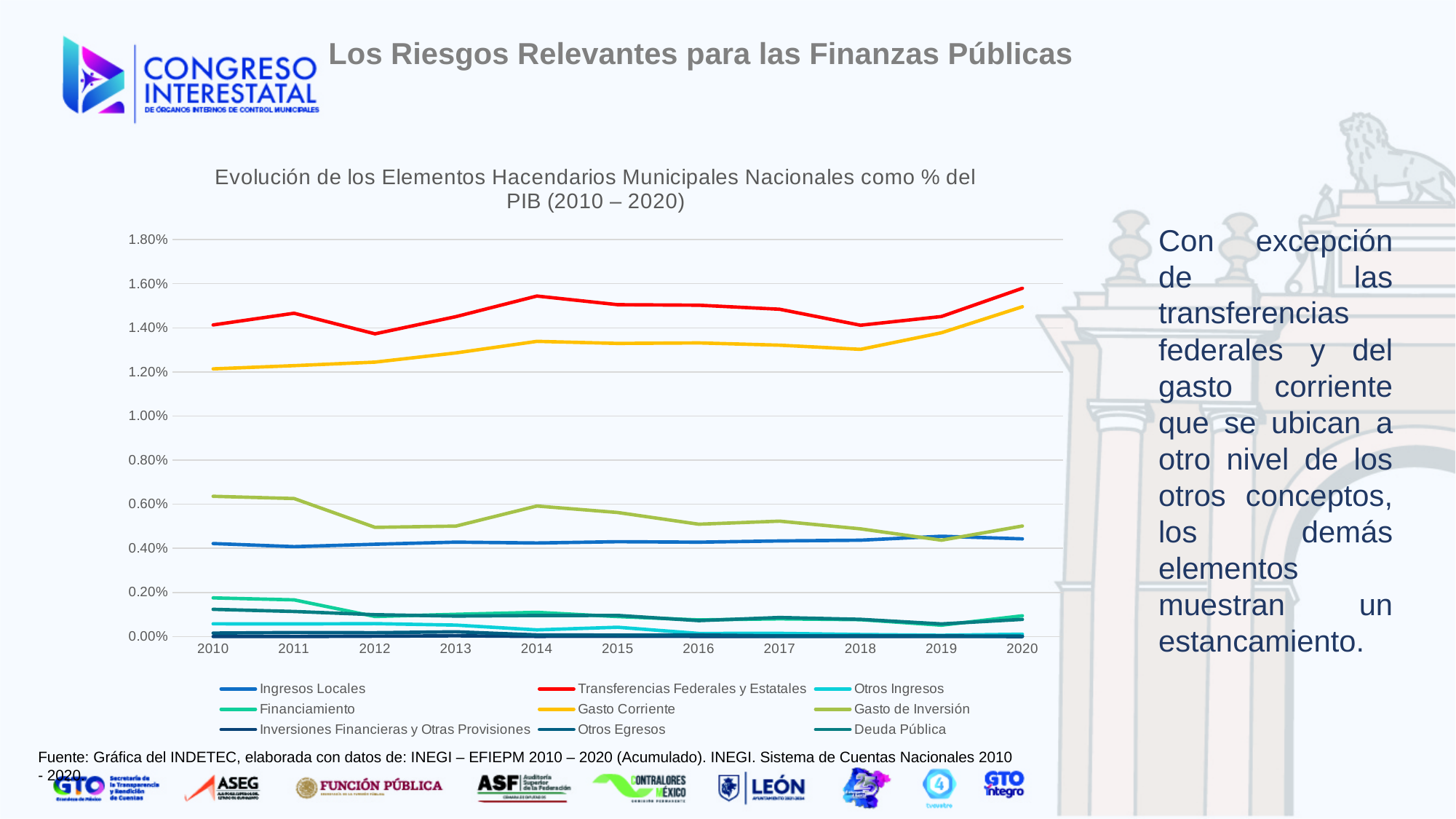
What is the title of the chart? Evolución de los Elementos Hacendarios Municipales Nacionales como % del PIB (2010 – 2020) In 2014, which is larger: Transferencias Federales y Estatales or Gasto Corriente? Transferencias Federales y Estatales Is the value for Gasto Corriente in 2010 greater or less than 1.00%? greater In 2010, which is larger: Gasto de Inversión or Ingresos Locales? Gasto de Inversión Is the value for Transferencias Federales y Estatales in 2020 greater or less than 1.40%? greater Does Gasto Corriente rise or fall from 2018 to 2020? Rise How many years are plotted along the x axis? 11 Is the value for Ingresos Locales in 2015 greater or less than 0.60%? less Does Gasto de Inversión rise or fall from 2010 to 2012? Fall How many series does the legend list? 9 Which series has the highest value in 2020? Transferencias Federales y Estatales What kind of chart is shown on the slide? Line chart